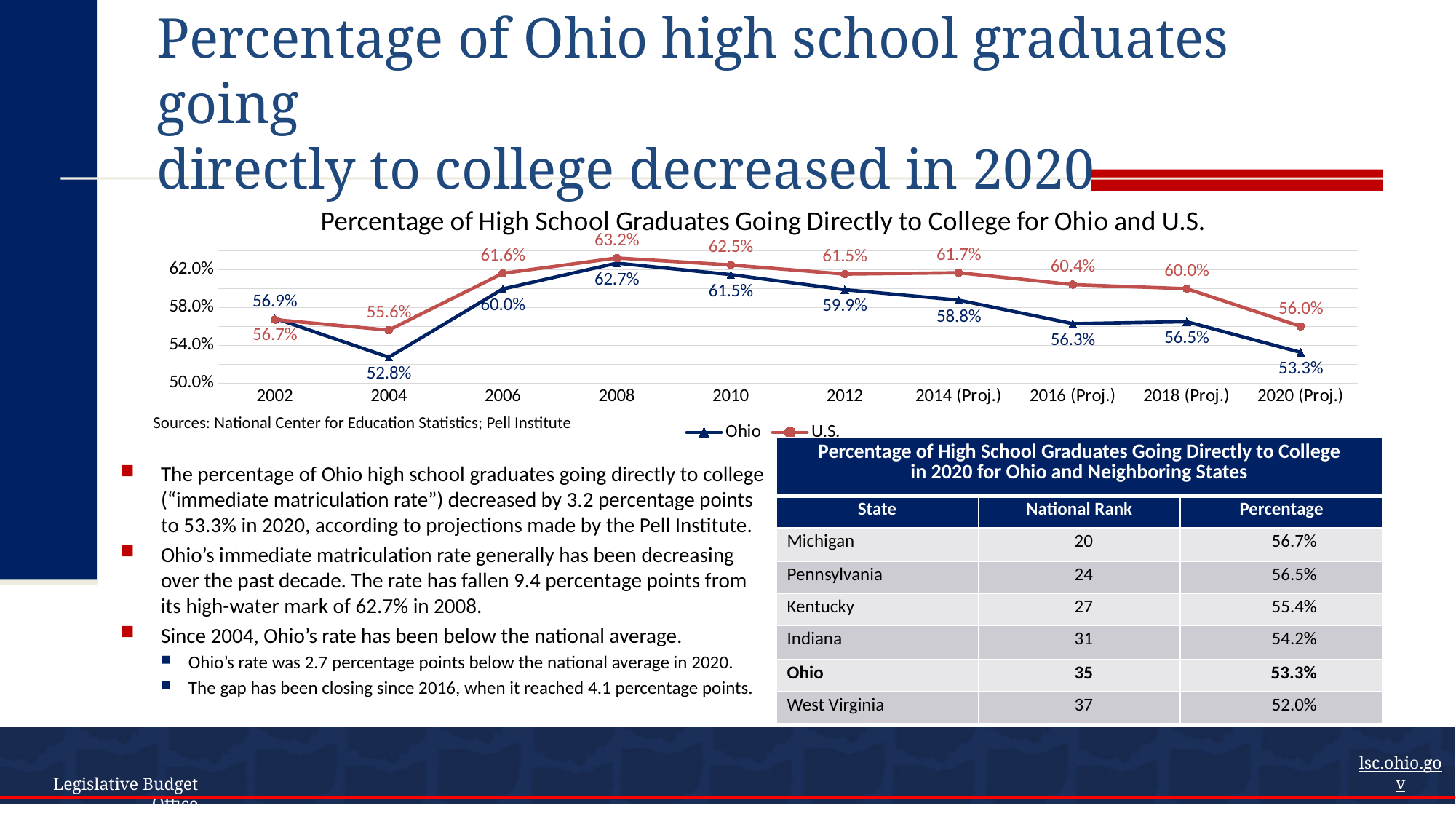
In which year does the Ohio series reach its lowest value? 2004 Is the Ohio value for 2020 (Proj.) greater or less than 54.0%? less What is the U.S. value for 2020 (Proj.) in the line chart? 56.0% What is the Ohio value for 2004 in the line chart? 52.8% What is the difference between the U.S. and Ohio values in 2016 (Proj.)? 4.1 percentage points How many years are shown on the x axis of the line chart? 10 In which year does the U.S. series reach its highest value? 2008 What is the Ohio value for 2008 in the line chart? 62.7% Does the Ohio series rise or fall from 2008 to 2020 (Proj.)? Fall What kind of chart is used to show the percentage of high school graduates going directly to college? Line chart How many series does the legend of the line chart list? 2 Which series has the higher value in 2012, Ohio or U.S.? U.S.